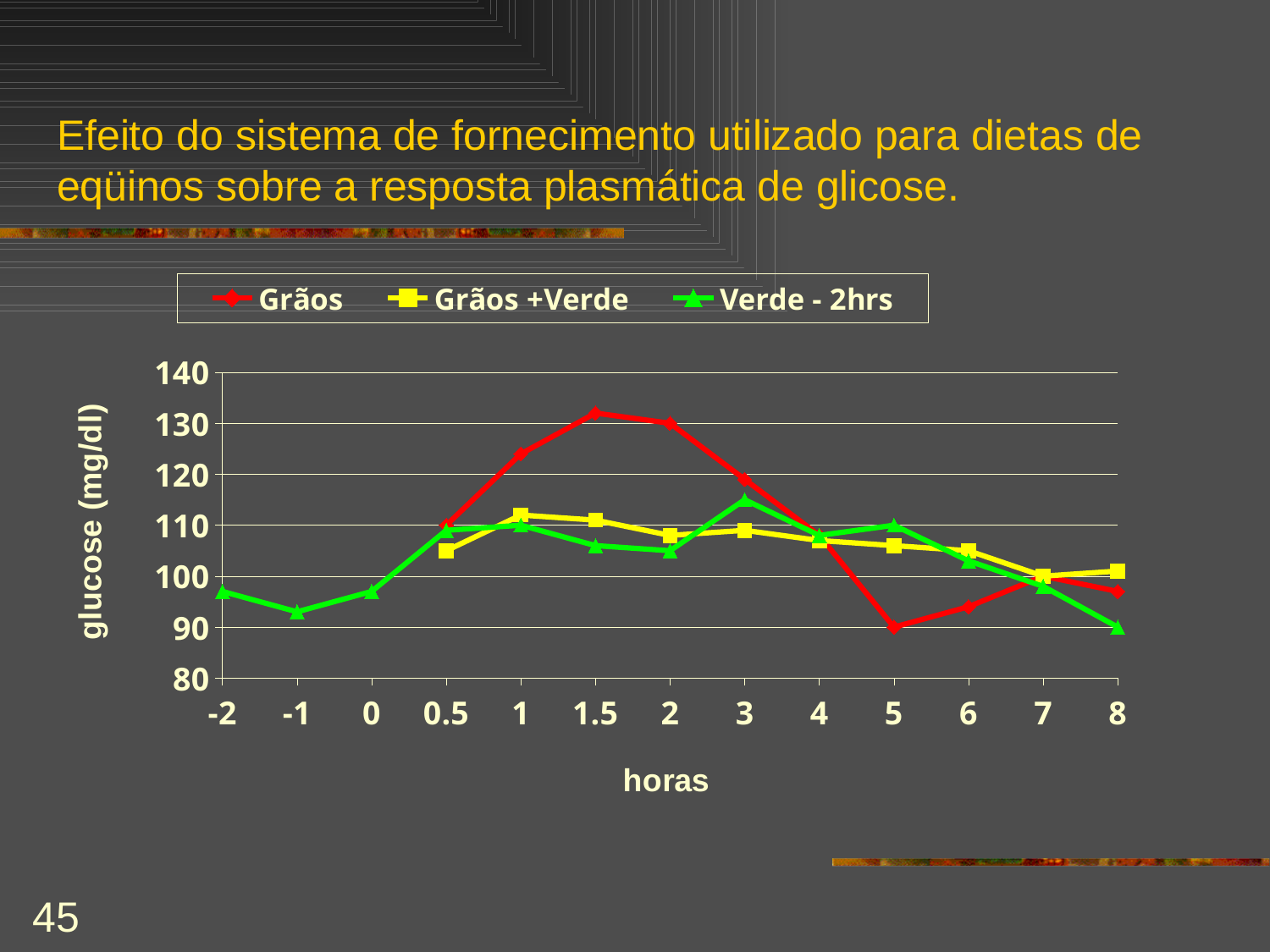
At 5 horas, which series has the lowest glucose value? Grãos How many series does the legend list? 3 At 2 horas, which is larger: Grãos or Verde - 2hrs? Grãos How many time points are shown on the x axis (horas)? 13 Does the Grãos series rise or fall between 0 and 1.5 horas? rise Is the value for Verde - 2hrs at 3 horas greater or less than 110? greater Which series reaches the highest glucose value on the chart? Grãos What is the label of the y axis? glucose (mg/dl) Is the value for Grãos at 5 horas greater or less than 100? less Is the value for Verde - 2hrs at -1 horas greater or less than 100? less What kind of chart is shown on the slide? line chart